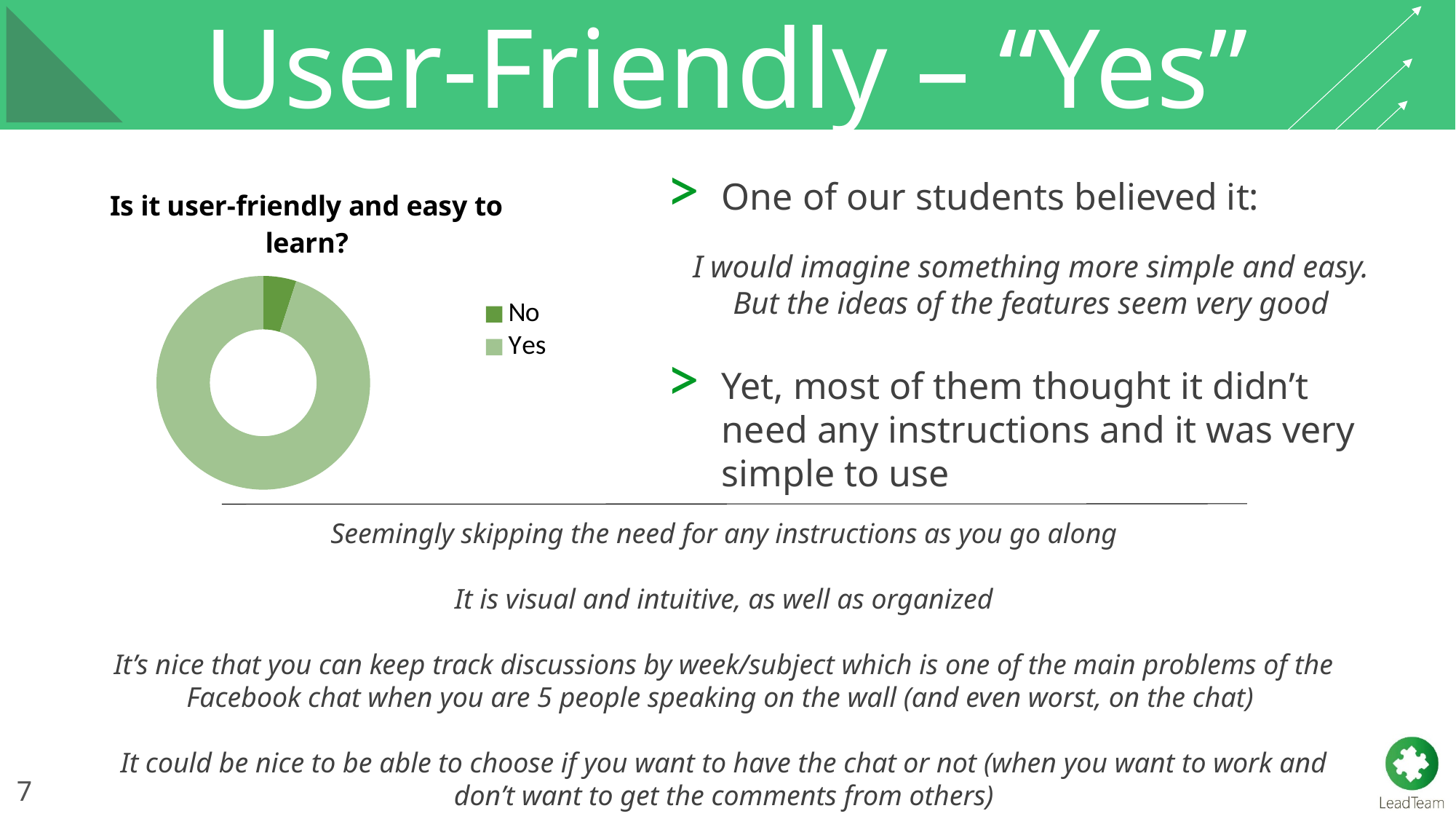
Which is larger in the chart, the share for Yes or the share for No? Yes How many entries does the chart's legend list? 2 What kind of chart is shown on the slide? doughnut chart What is the title of the chart on the slide? Is it user-friendly and easy to learn? What are the two legend entries of the chart? No and Yes Which category has the largest share of the chart? Yes Which category has the smallest share of the chart? No How many categories are shown in the chart? 2